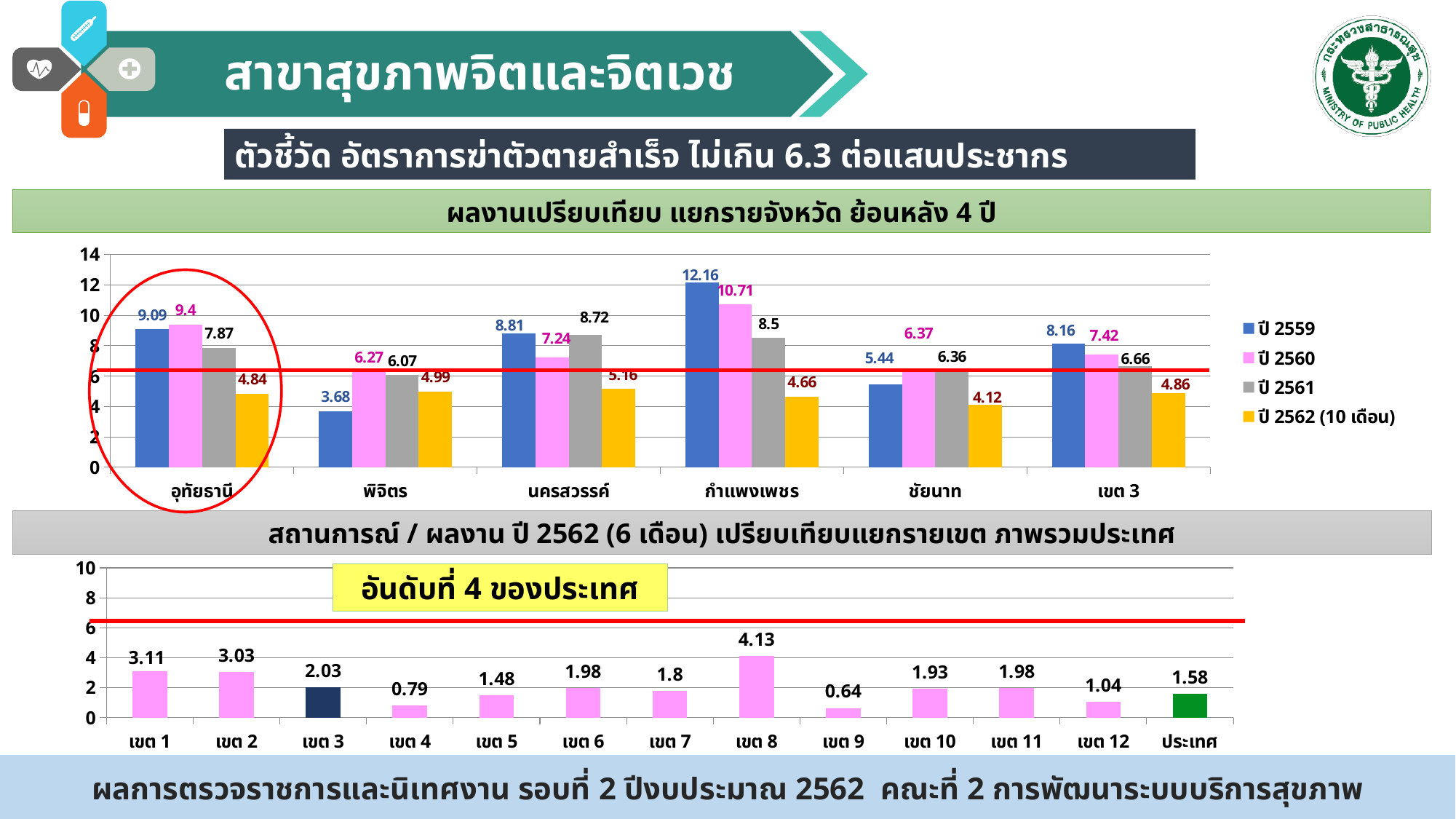
In the bottom chart, what is the difference between the values for เขต 3 and ประเทศ? 0.45 In the top chart, how many categories are shown on the x axis? 6 In the top chart, how many series does the legend list? 4 In the bottom chart, which category has the lowest value? เขต 9 In the top chart, what is the value for อุทัยธานี in the ปี 2559 series? 9.09 In the top chart, which category has the lowest value in the ปี 2562 (10 เดือน) series? ชัยนาท What kind of chart is the bottom chart? bar chart In the bottom chart, which is larger, the value for เขต 1 or the value for เขต 2? เขต 1 In the bottom chart, what is the value for เขต 8? 4.13 In the top chart, which category has the highest value in the ปี 2559 series? กำแพงเพชร In the top chart, what is the difference between the ปี 2559 and ปี 2561 values for นครสวรรค์? 0.09 In the top chart, what is the value for กำแพงเพชร in the ปี 2560 series? 10.71